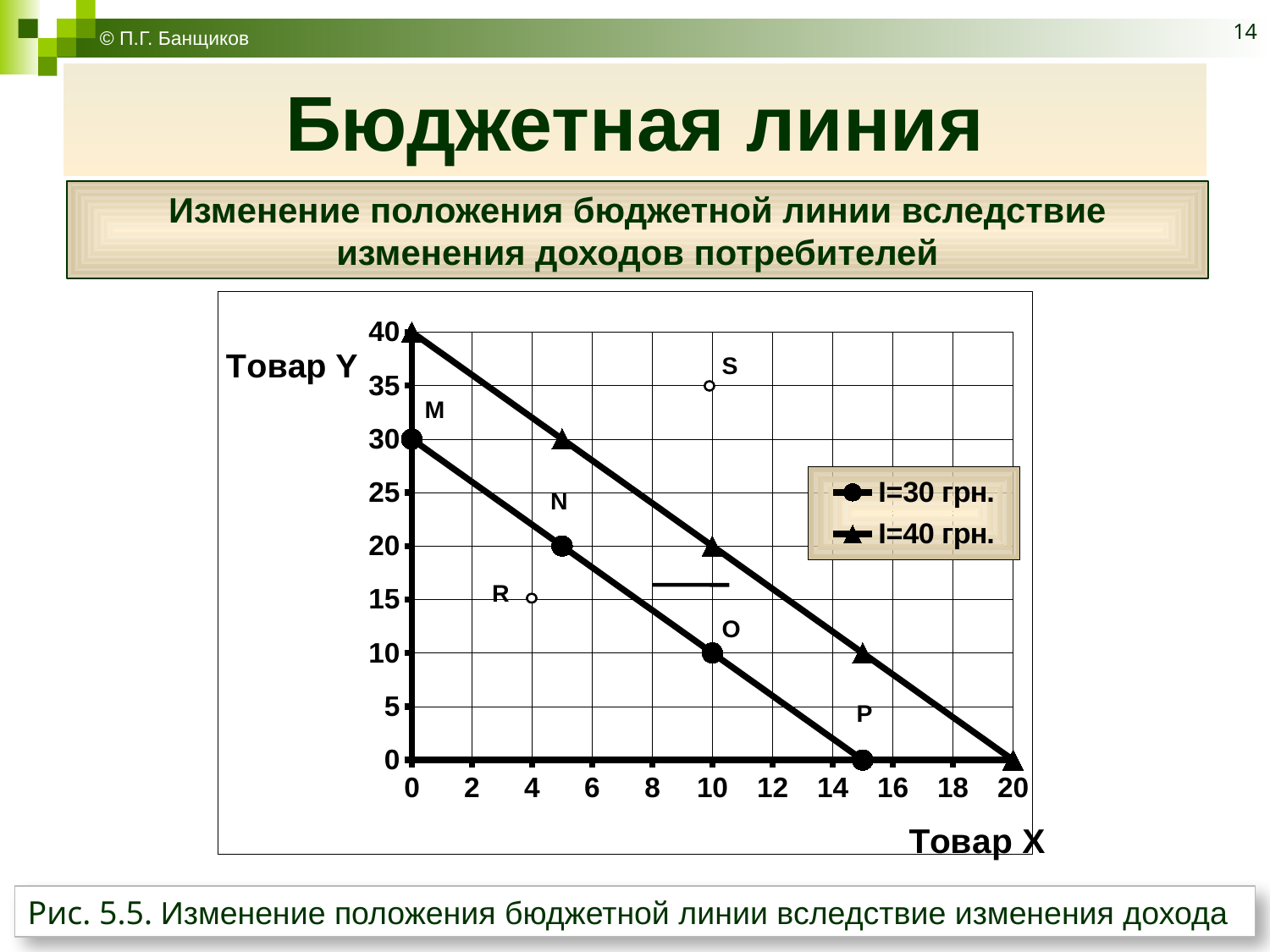
What is the value of Товар Y for the I=40 грн. line when Товар X is 0? 40 What kind of chart is shown on the slide? line chart What is the value of Товар Y for the I=40 грн. line when Товар X is 10? 20 Which line has the higher value of Товар Y at Товар X = 5, I=30 грн. or I=40 грн.? I=40 грн. What is the value of Товар Y for the I=30 грн. line when Товар X is 0? 30 Do the values of Товар Y rise or fall as Товар X increases along the I=30 грн. line? fall What is the difference in Товар Y between the I=40 грн. and I=30 грн. lines at Товар X = 10? 10 What is the label of the vertical axis? Товар Y What are the two series named in the legend? I=30 грн. and I=40 грн. How many series does the legend list? 2 At what value of Товар X does the I=30 грн. line reach Товар Y = 0? 15 At what value of Товар X does the I=40 грн. line reach Товар Y = 0? 20